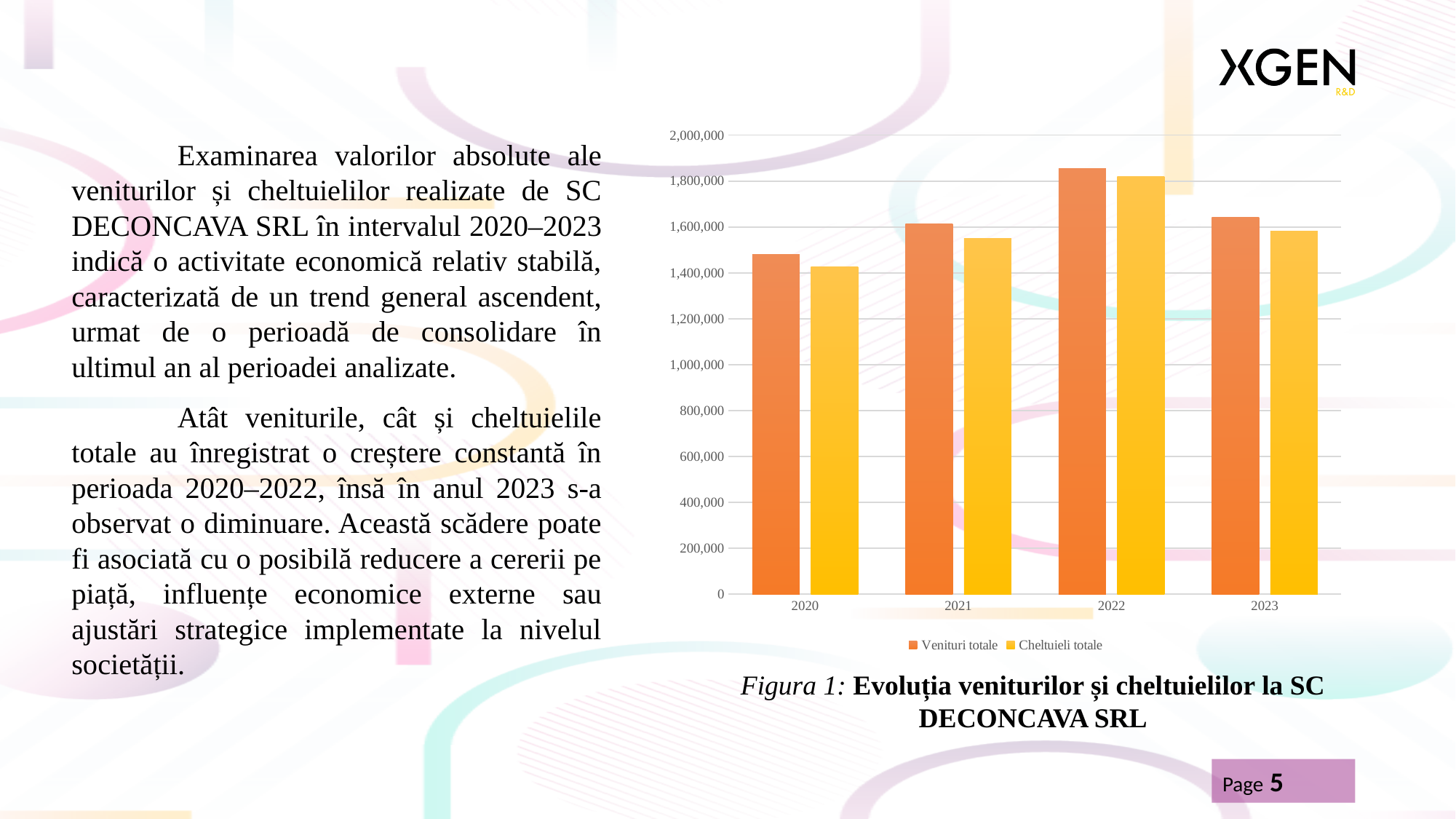
In which year is Cheltuieli totale highest? 2022 What kind of chart is shown on the slide? bar chart Is the value for Cheltuieli totale in 2022 greater or less than 1,600,000? greater Is the value for Venituri totale in 2022 greater or less than 1,800,000? greater In which year is Cheltuieli totale lowest? 2020 How many years are shown on the x axis of the chart? 4 In which year is Venituri totale highest? 2022 In which year is Venituri totale lowest? 2020 How many series does the legend list? 2 What are the two series named in the legend? Venituri totale and Cheltuieli totale Is the value for Cheltuieli totale in 2020 greater or less than 1,600,000? less In 2021, which is larger: Venituri totale or Cheltuieli totale? Venituri totale